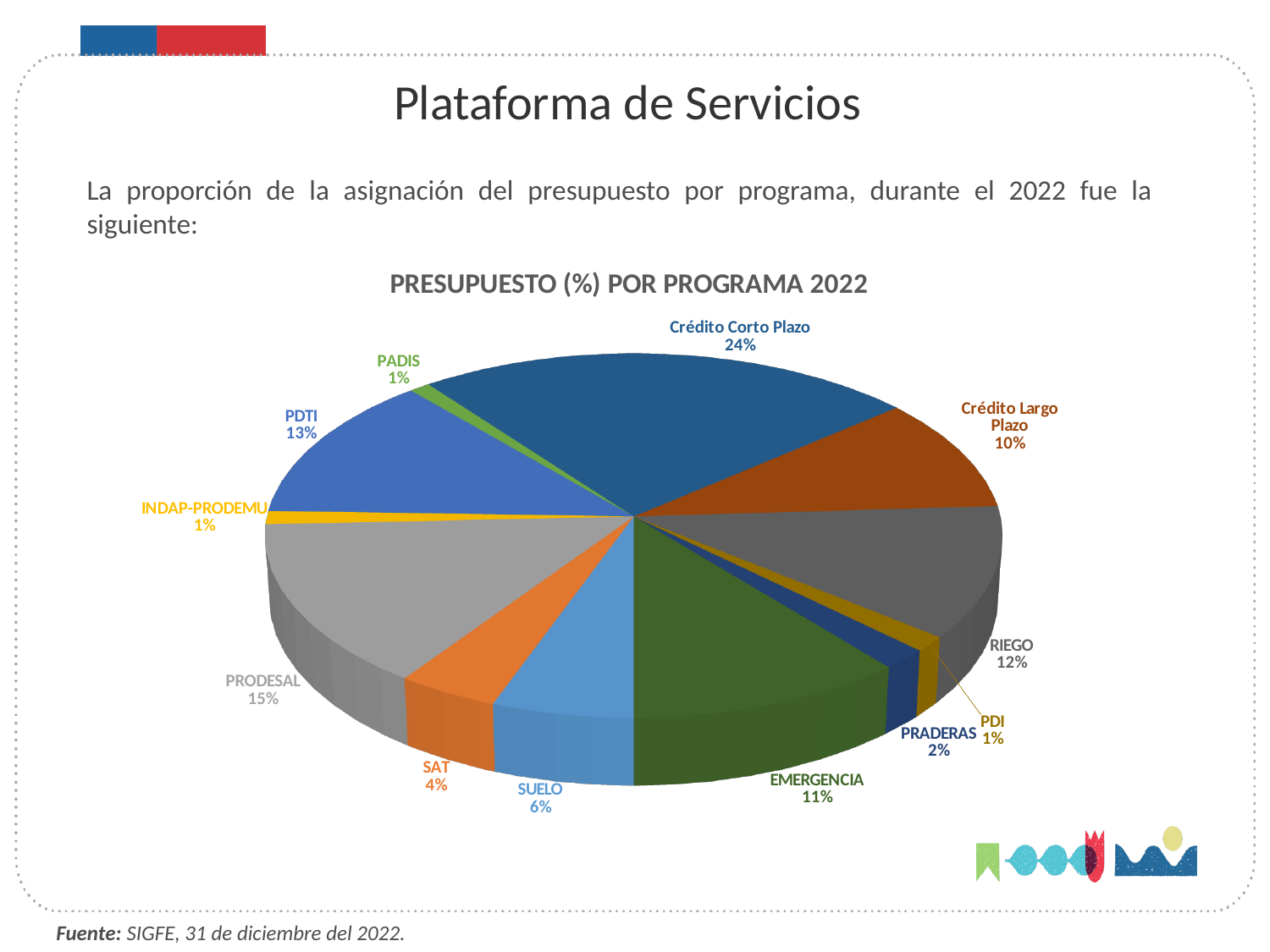
Which program has the largest share of the budget? Crédito Corto Plazo What percentage is shown for PRADERAS? 2% What share of the budget does Crédito Corto Plazo have? 24% What kind of chart is shown on the slide? Pie chart How many programs (slices) are shown in the pie chart? 12 What percentage is shown for SUELO? 6% What percentage is shown for PRODESAL? 15% What percentage is shown for EMERGENCIA? 11% What is the difference in percentage points between Crédito Corto Plazo and Crédito Largo Plazo? 14 What is the difference in percentage points between PDTI and RIEGO? 1 What is the title of the chart? PRESUPUESTO (%) POR PROGRAMA 2022 Which is larger, the share for Crédito Largo Plazo or the share for SAT? Crédito Largo Plazo